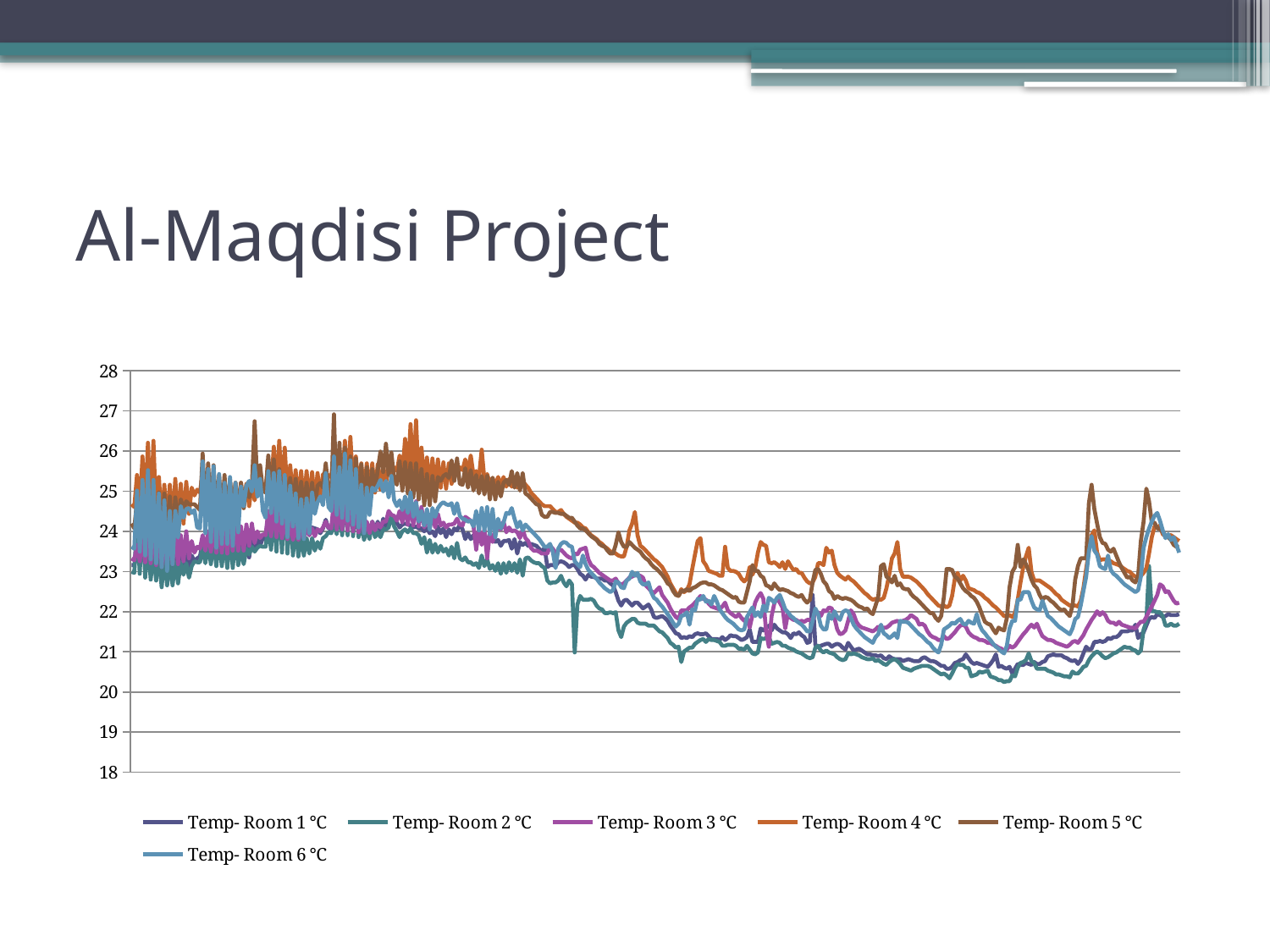
What kind of chart is shown on the slide? line chart Is the highest value plotted for Temp- Room 5 °C greater or less than 28? less Is the lowest value plotted for Temp- Room 4 °C greater or less than 21? greater At the right end of the chart, which is higher: Temp- Room 4 °C or Temp- Room 2 °C? Temp- Room 4 °C What is the highest value shown on the chart's vertical axis? 28 Which series is listed last in the chart's legend? Temp- Room 6 °C Is the lowest value plotted for Temp- Room 2 °C greater or less than 19? greater How many series does the chart's legend list? 6 Overall, do the temperature values rise or fall from the left of the chart to the right? fall